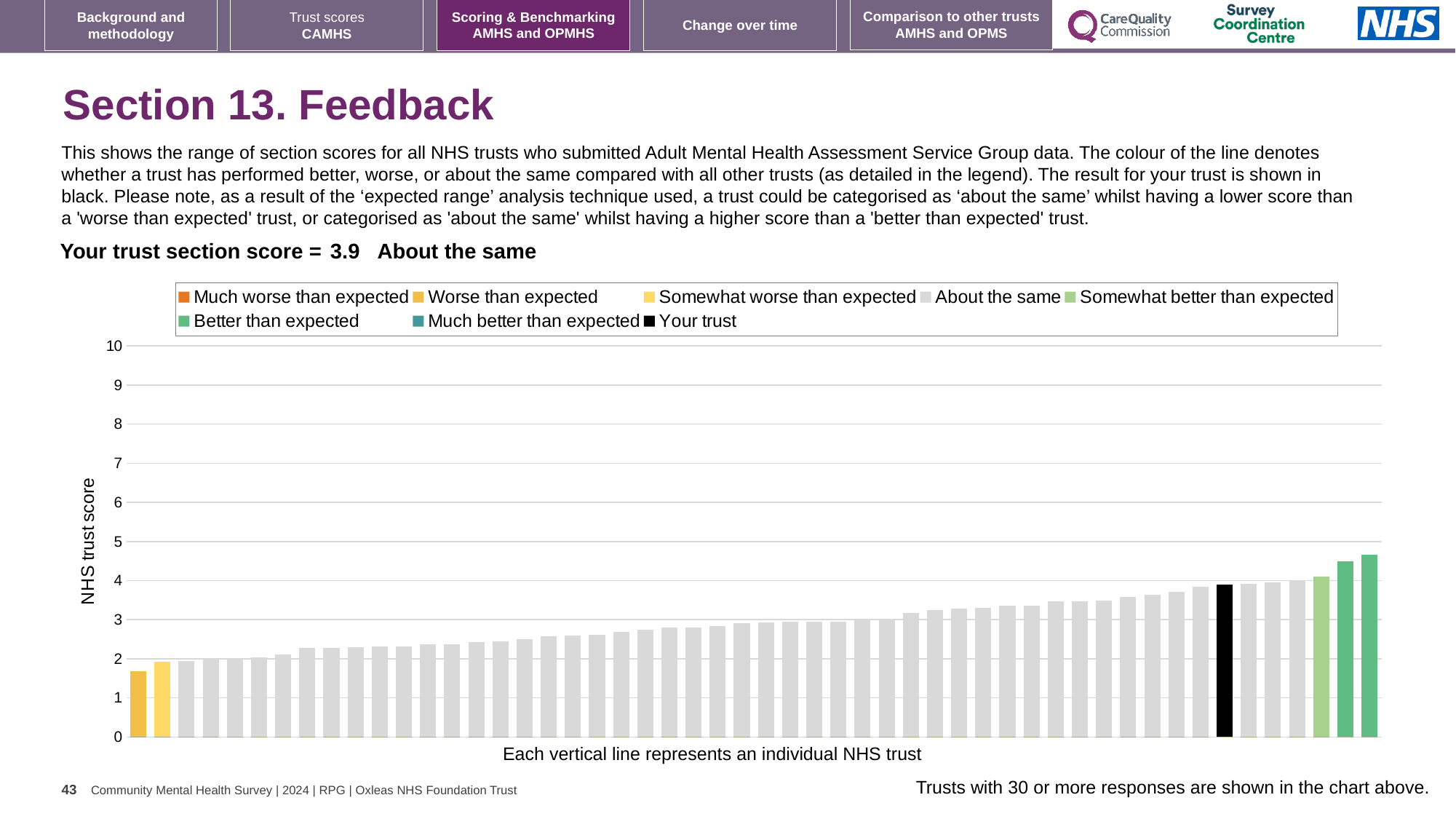
How many bars are coloured as 'Better than expected'? 2 What colour is the bar representing your trust? black What is the label on the vertical axis of the chart? NHS trust score Do the bar values rise or fall from left to right along the x axis? rise Is the value for your trust (the black bar) greater or less than 3? greater What is the section score for your trust shown on the slide? 3.9 How many entries does the chart legend list? 8 What kind of chart is shown on the slide? bar chart Which category is your trust's section score placed in? About the same Is the value of the tallest bar in the chart greater or less than 5? less Is the value of the shortest bar in the chart greater or less than 2? less Is your trust's bar higher or lower than the tallest 'Better than expected' bar? lower